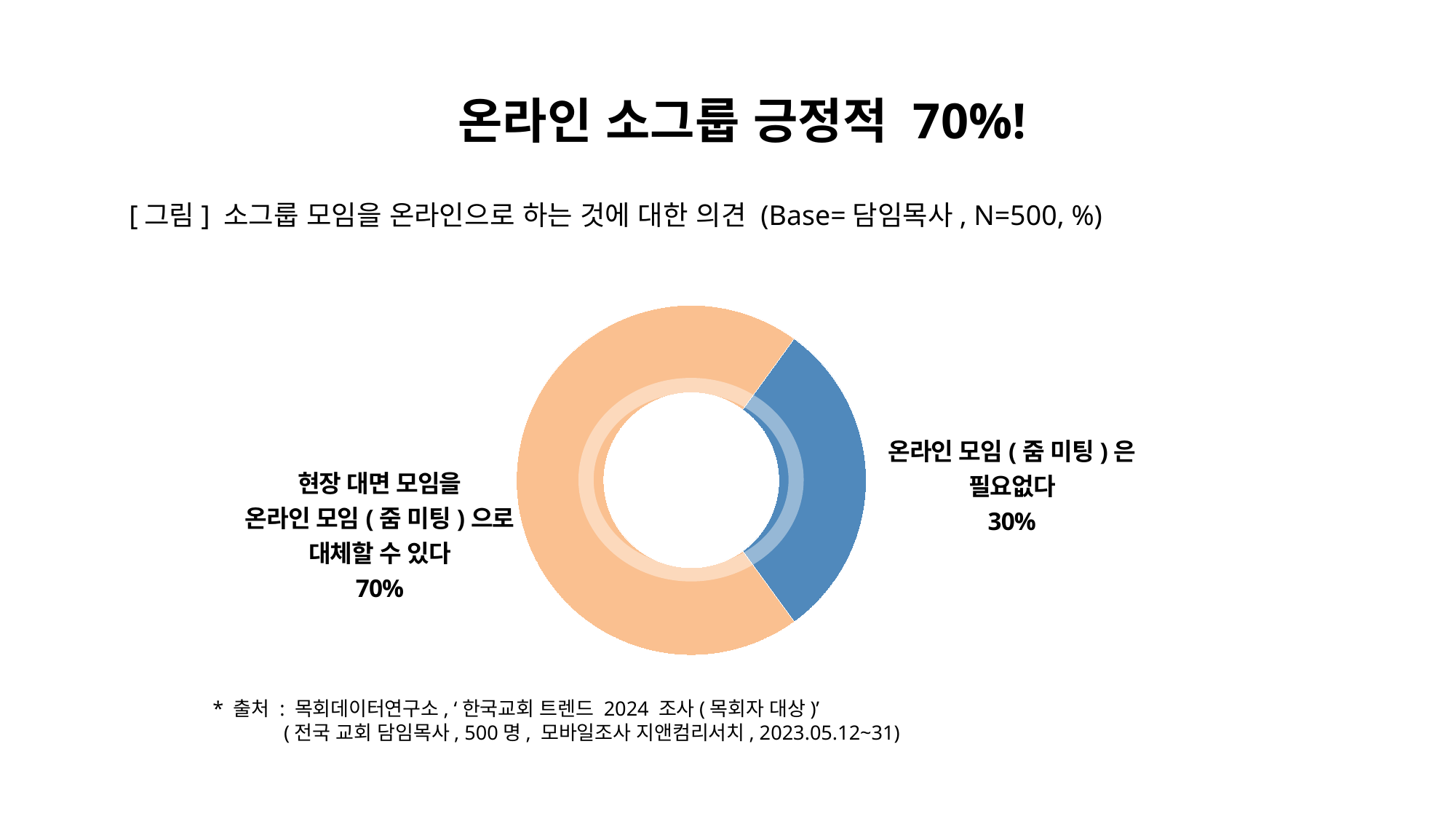
What is the difference in percentage points between the '대체할 수 있다' share and the '필요없다' share? 40 percentage points What share of respondents said '현장 대면 모임을 온라인 모임(줌 미팅)으로 대체할 수 있다'? 70% Which is larger: the share for '대체할 수 있다' or the share for '필요없다'? 대체할 수 있다 What kind of chart is shown on the slide? Pie (donut) chart Which response has the largest share in the chart? 현장 대면 모임을 온라인 모임(줌 미팅)으로 대체할 수 있다 What is the sample size (N) stated in the figure caption? 500 What colour is the slice representing '온라인 모임(줌 미팅)은 필요없다'? Blue What is the total of the two slices shown in the chart? 100% How many slices does the donut chart have? 2 Which response has the smallest share in the chart? 온라인 모임(줌 미팅)은 필요없다 What share of respondents said '온라인 모임(줌 미팅)은 필요없다'? 30%